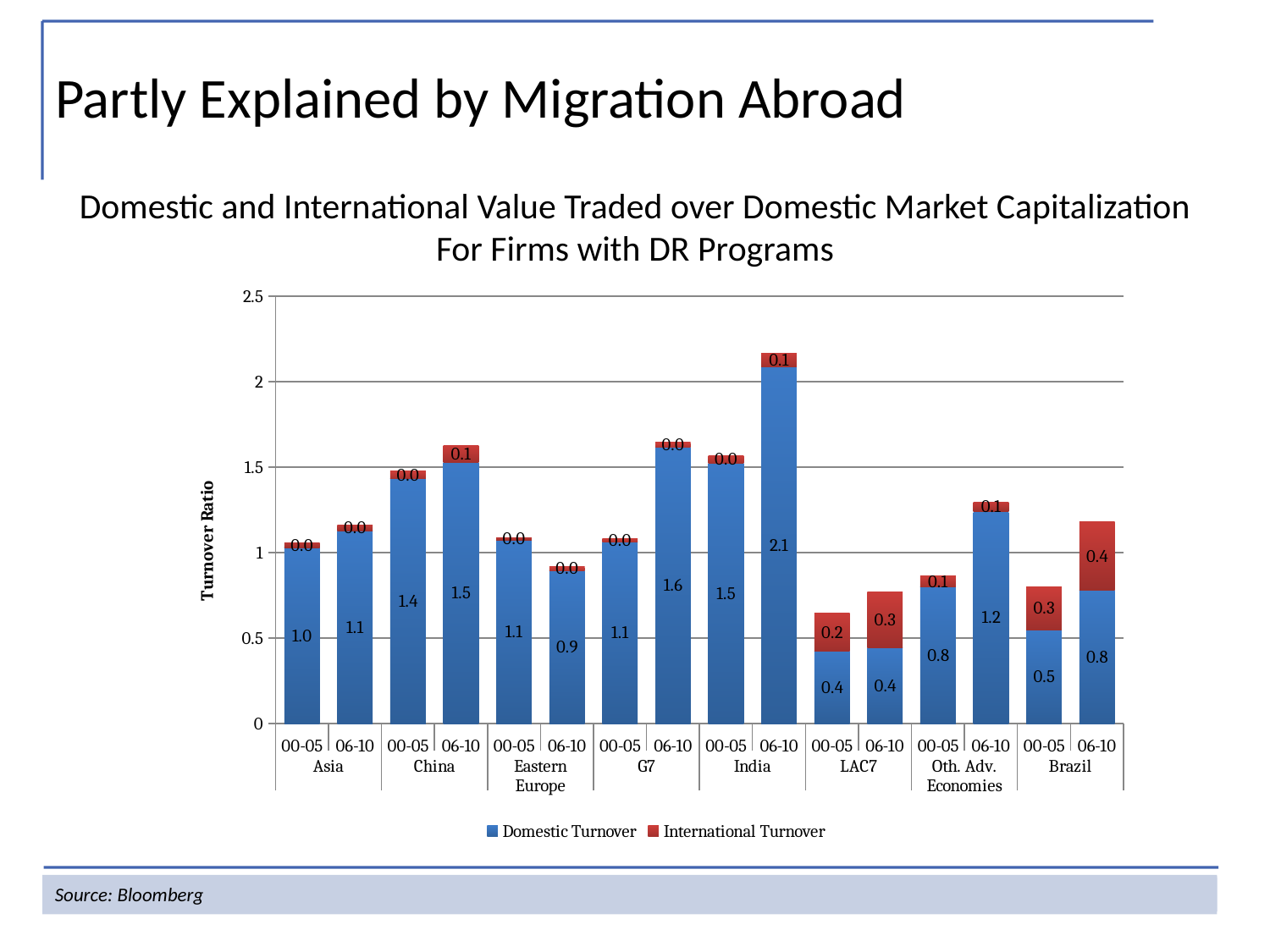
Which is larger: the Domestic Turnover for G7 in 06-10 or for China in 06-10? G7 in 06-10 How many regions are shown on the x axis? 8 How many series does the legend list? 2 Is the total bar height for India in 06-10 greater or less than 2? greater What is the Domestic Turnover value for India in 06-10? 2.1 What is the International Turnover value for Brazil in 06-10? 0.4 What is the Domestic Turnover value for Eastern Europe in 06-10? 0.9 What kind of chart is shown on the slide? Stacked bar chart Which region and period has the highest Domestic Turnover? India, 06-10 Which region has the lowest Domestic Turnover? LAC7 Which region and period has the highest International Turnover? Brazil, 06-10 By how much did India's Domestic Turnover increase from 00-05 to 06-10? 0.6